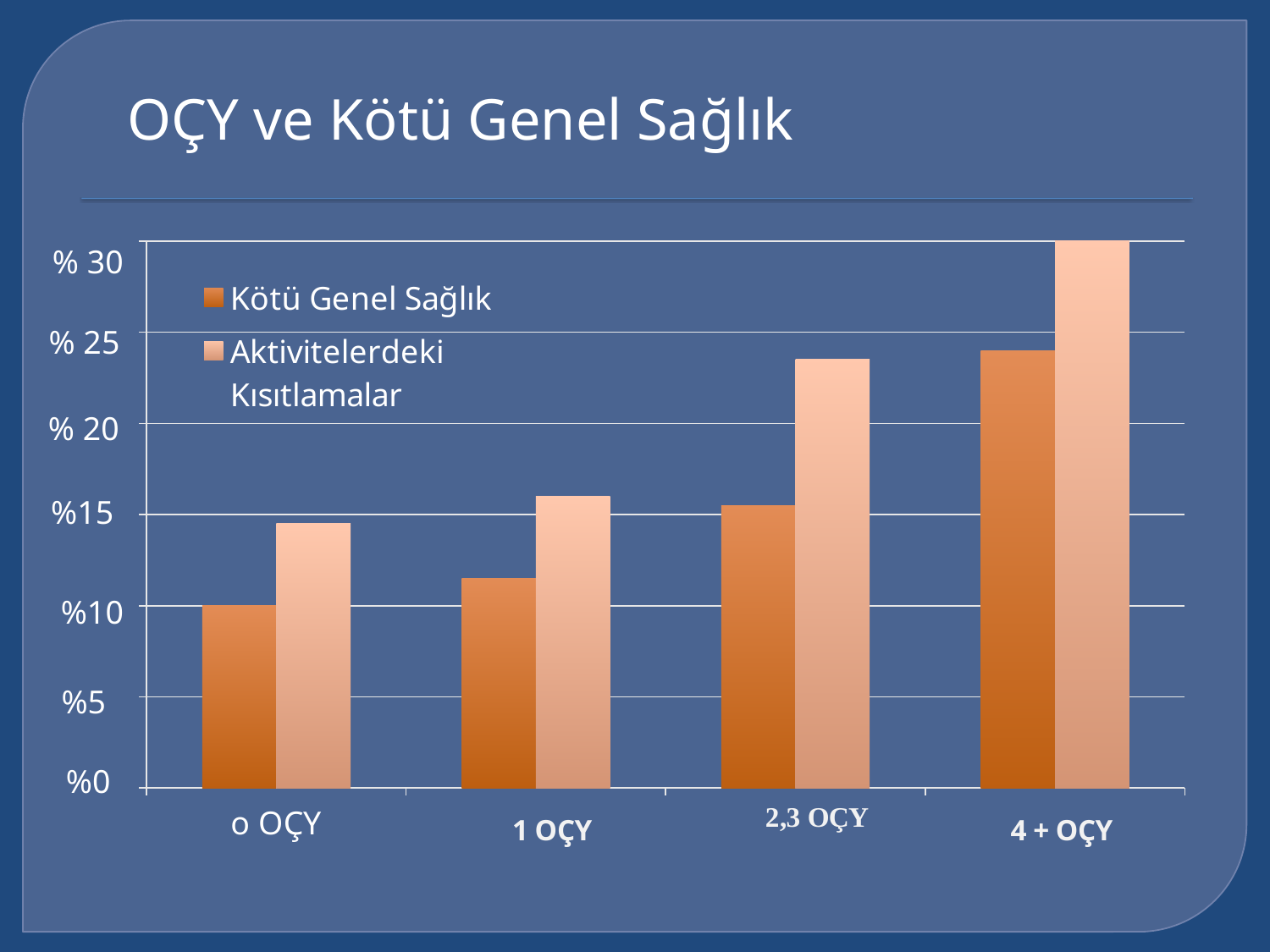
Which category has the highest value for Aktivitelerdeki Kısıtlamalar? 4 + OÇY Do the Kötü Genel Sağlık values rise or fall from o OÇY to 4 + OÇY? rise How many categories are shown on the x axis? 4 What kind of chart is shown on the slide? bar chart For 2,3 OÇY, which series has the larger value: Kötü Genel Sağlık or Aktivitelerdeki Kısıtlamalar? Aktivitelerdeki Kısıtlamalar Is the Aktivitelerdeki Kısıtlamalar value for 1 OÇY greater or less than %20? less Which category has the highest value for Kötü Genel Sağlık? 4 + OÇY Is the Kötü Genel Sağlık value for 4 + OÇY greater or less than %20? greater What is the title of the chart? OÇY ve Kötü Genel Sağlık Which category has the lowest value for Kötü Genel Sağlık? o OÇY Is the Aktivitelerdeki Kısıtlamalar value for 4 + OÇY greater or less than %25? greater How many series does the legend list? 2